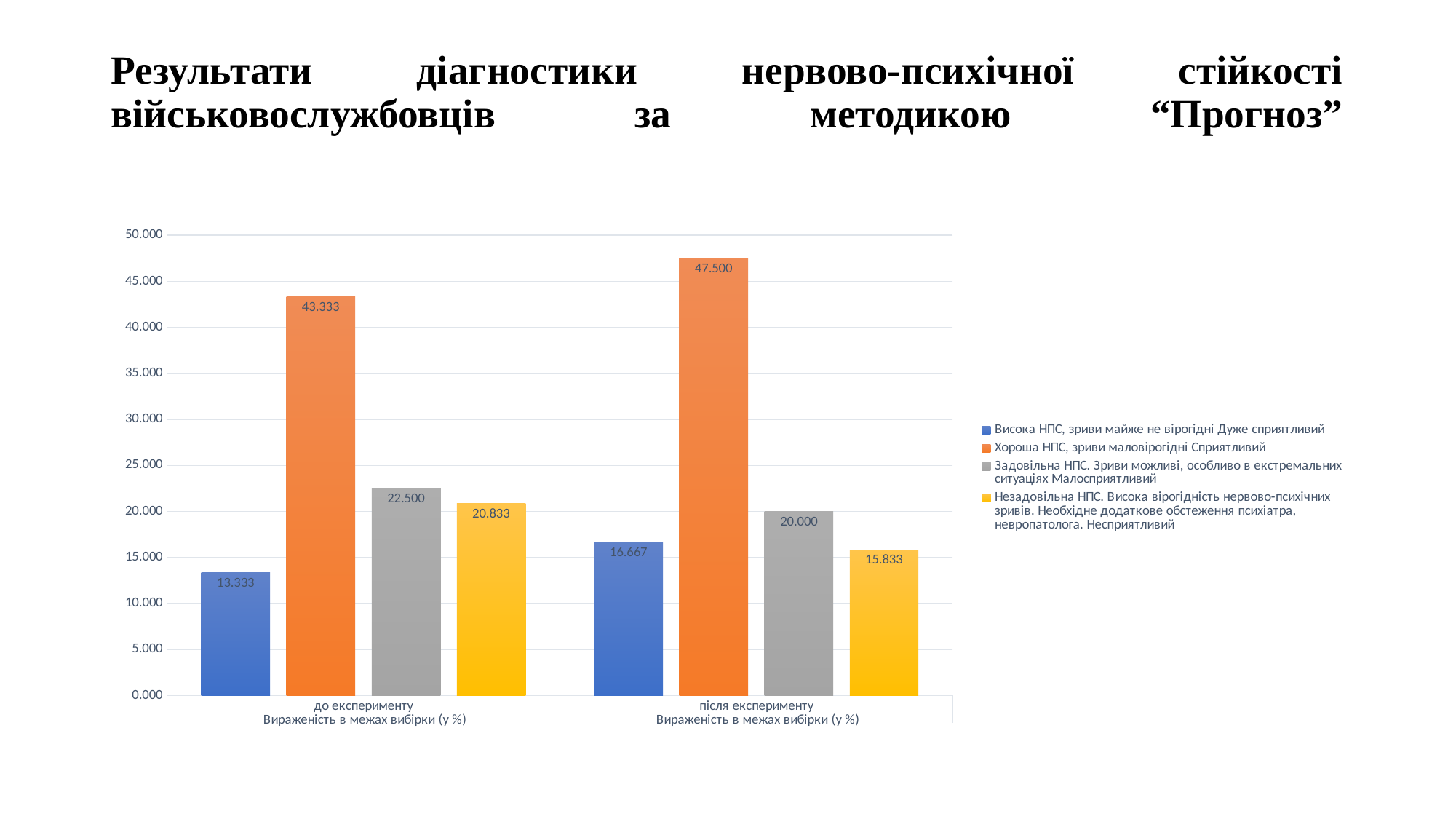
Which series has the highest value in the "після експерименту" group? Хороша НПС, зриви маловірогідні Сприятливий Which is larger: the "Задовільна НПС" value before the experiment or after the experiment? до експерименту (22.500) What kind of chart is shown on the slide? bar chart What colour represents the "Задовільна НПС" series? grey How many category groups are shown on the x axis? 2 What is the value for "Висока НПС, зриви майже не вірогідні Дуже сприятливий" in the "після експерименту" group? 16.667 Is the value for "Хороша НПС" in the "після експерименту" group greater or less than 45.000? greater What is the difference between the "Хороша НПС" values after and before the experiment (47.500 minus 43.333)? 4.167 Which series has the lowest value in the "до експерименту" group? Висока НПС, зриви майже не вірогідні Дуже сприятливий What is the value for "Хороша НПС, зриви маловірогідні Сприятливий" in the "до експерименту" group? 43.333 What is the value for "Незадовільна НПС..." (yellow series) in the "до експерименту" group? 20.833 How many series does the legend list? 4